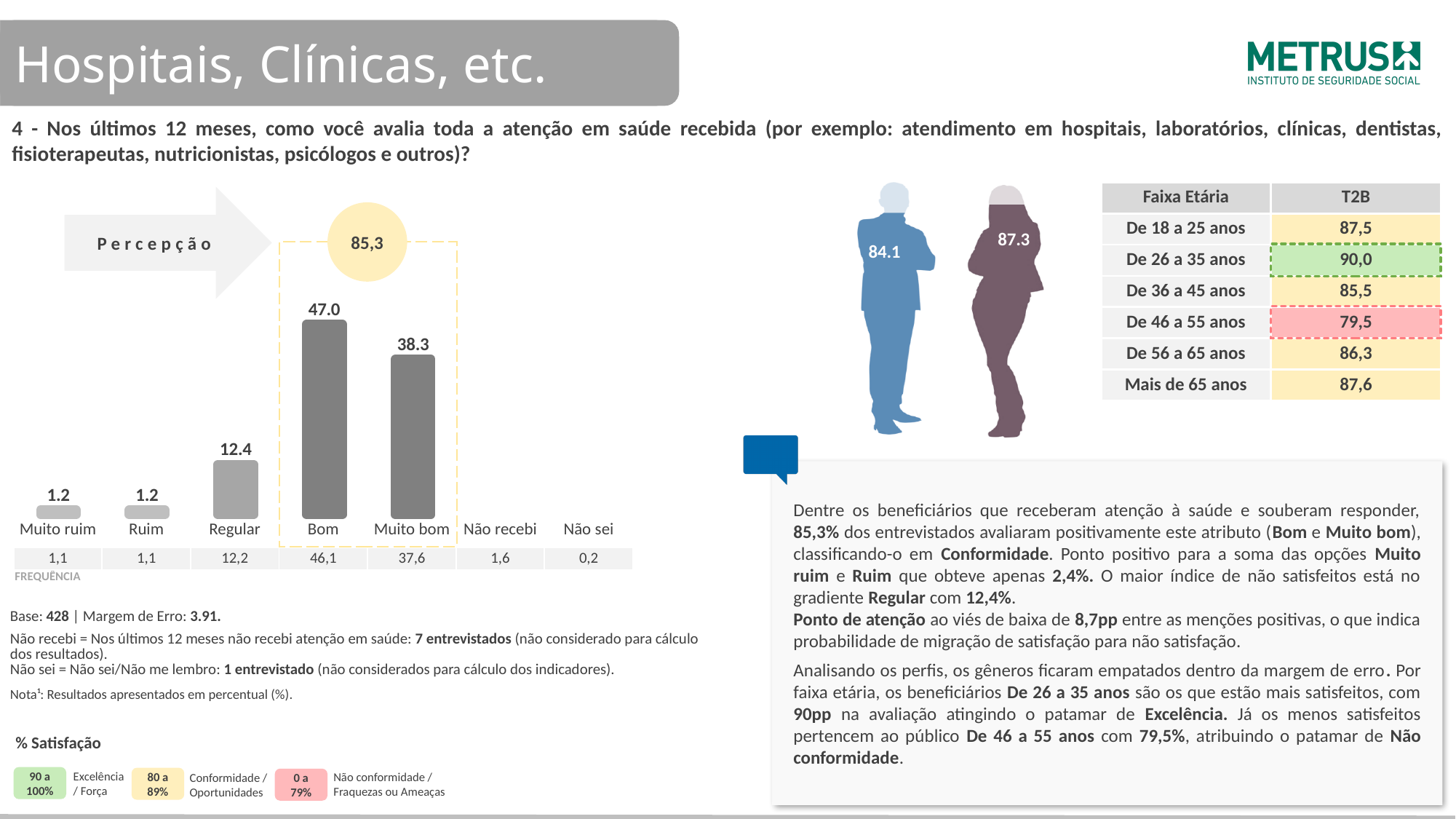
What is the difference between the Bom and Muito bom values in the chart? 8.7 Which category has the highest bar in the chart? Bom What is the value shown for the Muito bom bar in the chart? 38.3 What value is shown in the yellow circle above the dashed box around Bom and Muito bom? 85,3 What is the difference between the Regular and Ruim values in the chart? 11.2 Which is larger in the chart, the value for Regular or the value for Ruim? Regular What is the value shown for the Muito ruim bar in the chart? 1.2 What is the value shown for the Bom bar in the chart? 47.0 What is the value shown for the Regular bar in the chart? 12.4 What kind of chart is shown on the slide? Bar chart In the FREQUÊNCIA row below the chart, what is the value for Bom? 46,1 In the FREQUÊNCIA row below the chart, what is the value for Não recebi? 1,6